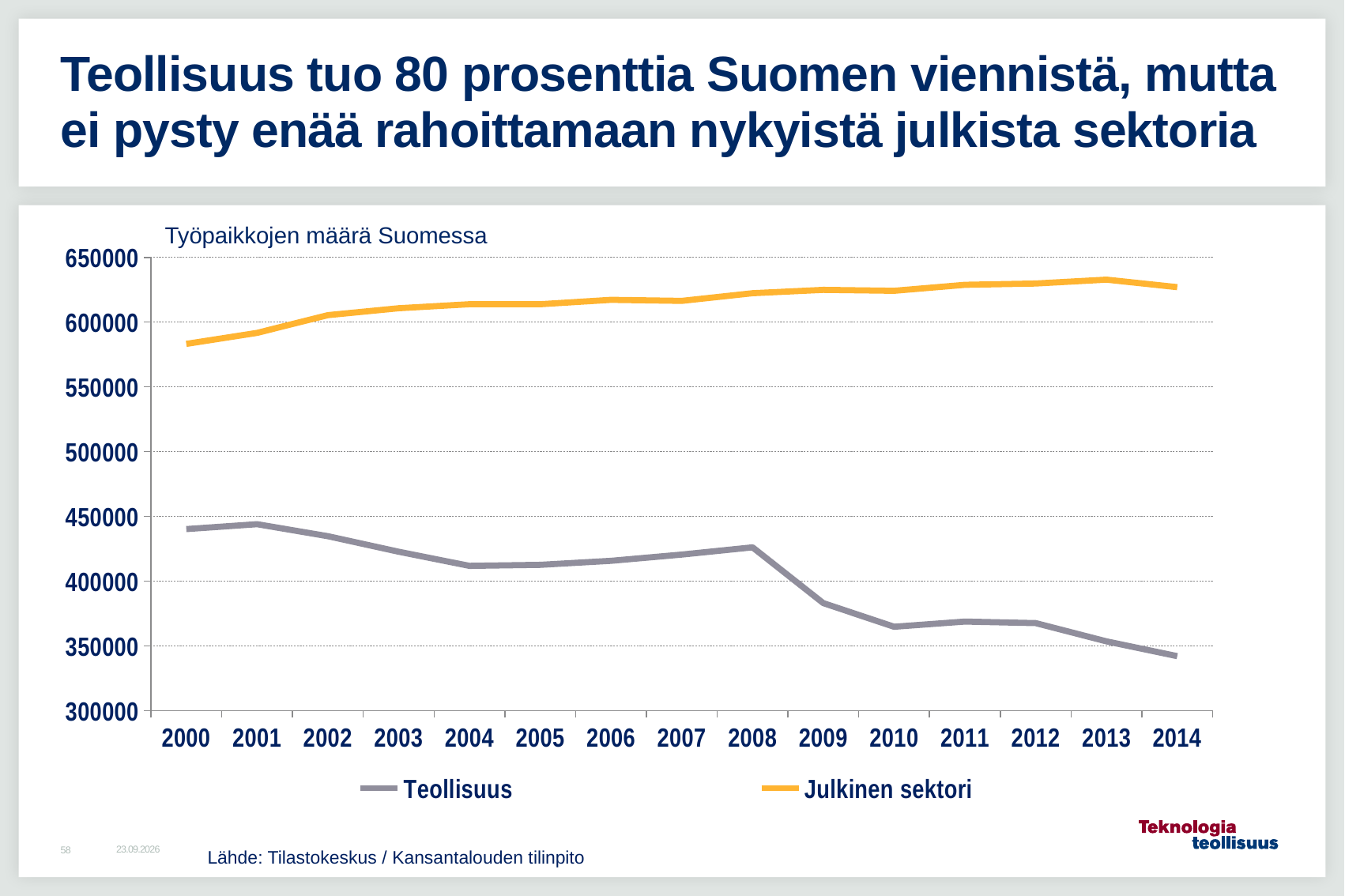
Which series has the larger value in 2014, Teollisuus or Julkinen sektori? Julkinen sektori Does the Julkinen sektori line rise or fall overall from 2000 to 2014? rise Is the value for Julkinen sektori in 2000 greater or less than 600000? less Is the value for Teollisuus in 2008 greater or less than 400000? greater What kind of chart is shown on the slide? line chart In which year is the Teollisuus line at its lowest? 2014 How many years are plotted along the x axis? 15 In which year is the Julkinen sektori line at its highest? 2013 Is the value for Teollisuus in 2014 greater or less than 350000? less What is the title of the chart? Työpaikkojen määrä Suomessa How many series does the legend list? 2 Does the Teollisuus line rise or fall overall from 2000 to 2014? fall